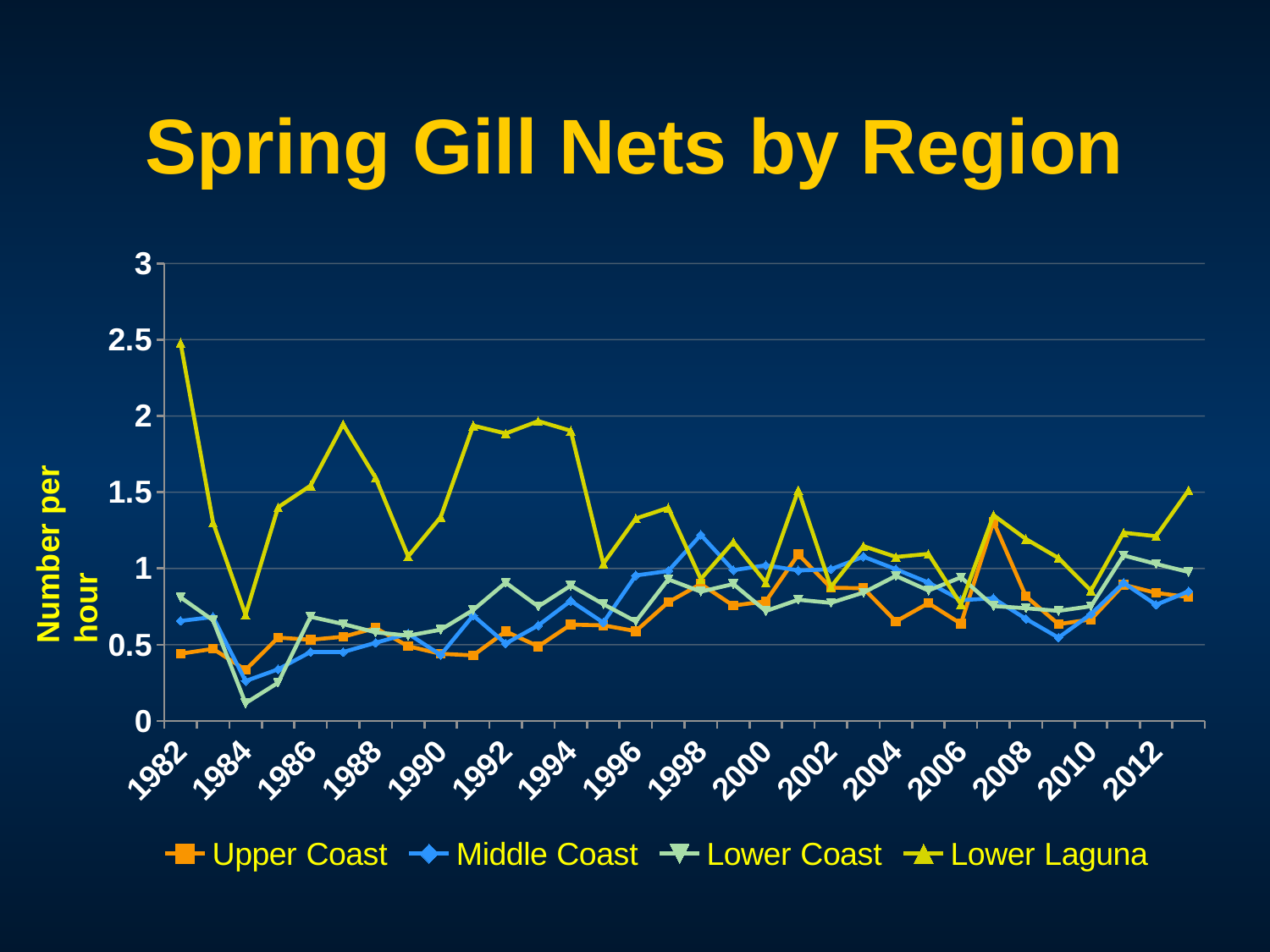
Which region has the lowest value in 1984? Lower Coast What is the label on the vertical axis? Number per hour What is the title of the chart? Spring Gill Nets by Region Is the value for Lower Laguna in 1982 greater or less than 2? greater Which region has the highest value in 1982? Lower Laguna Does the Lower Laguna line rise or fall from 1982 to 1984? fall Is the value for Lower Laguna in 1994 greater or less than 1.5? greater How many series does the legend list? 4 What kind of chart is shown on the slide? line chart In 1982, which is larger: the value for Lower Laguna or the value for Upper Coast? Lower Laguna Is the value for Lower Coast in 1984 greater or less than 0.5? less